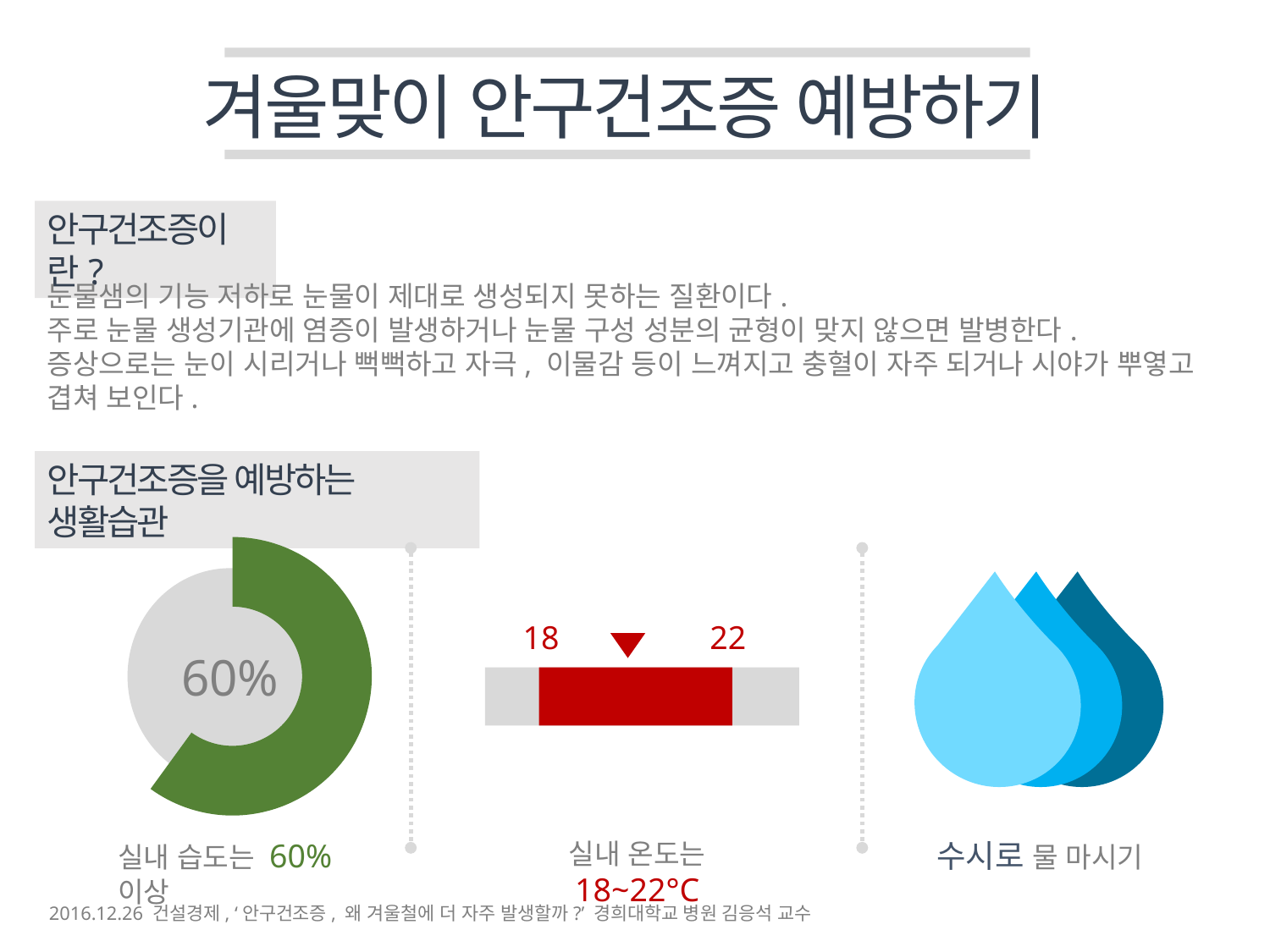
What value is printed in the centre of the donut chart? 60% In the temperature range bar in the middle of the slide, what is the upper value printed at the right end of the red section? 22 In the donut chart, which segment is larger, the green one or the grey one? green What caption appears below the donut chart? 실내 습도는 60% 이상 What colour is the filled (highlighted) segment of the donut chart? green What temperature range is printed below the middle bar graphic? 18~22°C How many segments does the donut chart have? 2 Is the value shown in the donut chart greater or less than 50%? greater What is the difference between the upper and lower values marked on the temperature range bar? 4 In the temperature range bar in the middle of the slide, what is the lower value printed at the left end of the red section? 18 What share of the donut chart does the green segment represent? 60% What kind of chart is shown on the left of the slide under '안구건조증을 예방하는 생활습관'? donut (pie) chart